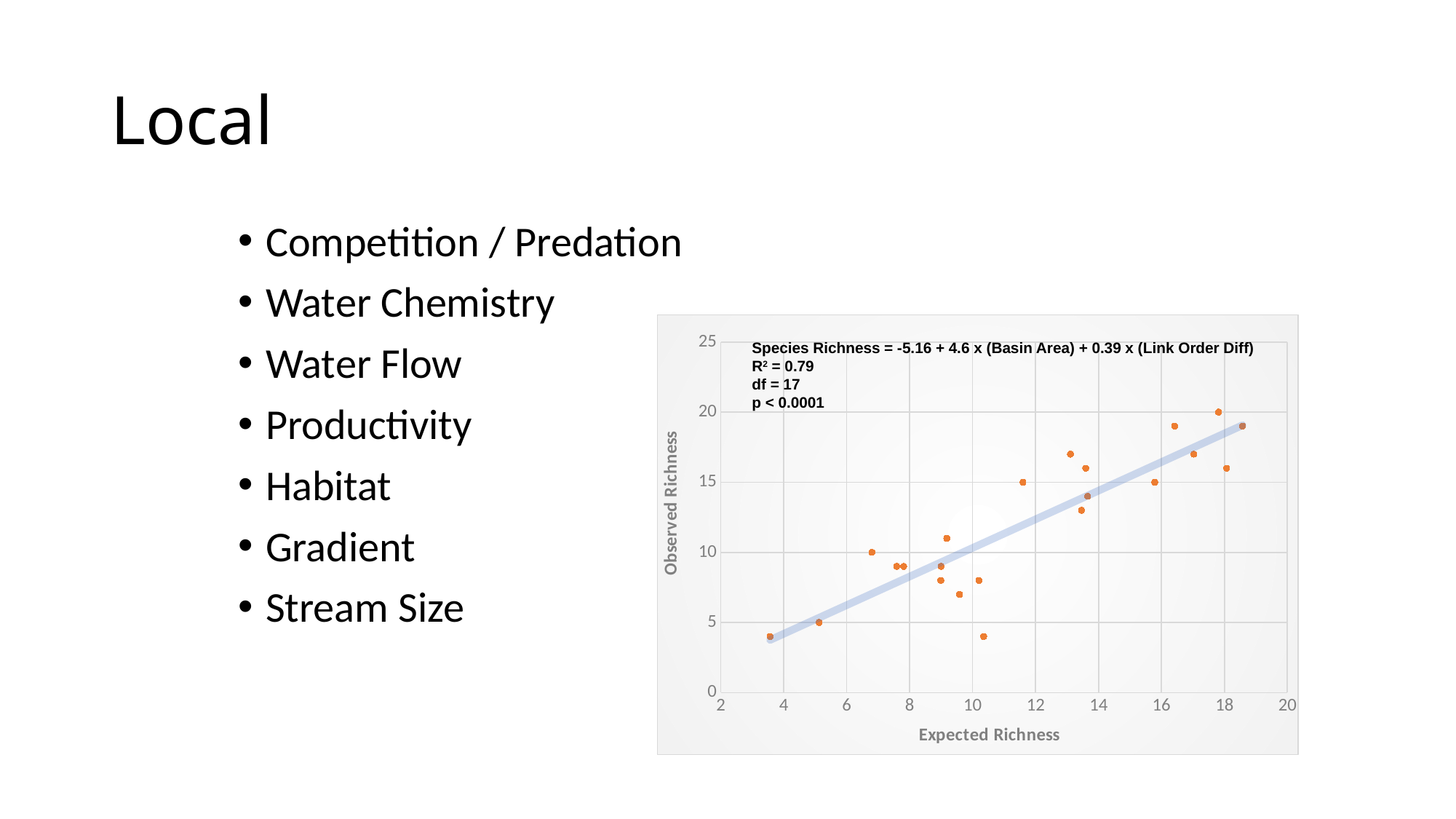
Do the plotted points generally rise or fall as Expected Richness increases along the x axis? rise Is the lowest Observed Richness value among the plotted points greater or less than 5? less What kind of chart is shown on the slide? scatter chart What is the title of the x axis of the chart? Expected Richness What is the title of the y axis of the chart? Observed Richness Is the highest Observed Richness value among the plotted points greater or less than 15? greater Is the largest Expected Richness value among the plotted points greater or less than 16? greater What R² value is printed on the chart? 0.79 What p-value is printed on the chart? p < 0.0001 What degrees of freedom (df) value is printed on the chart? 17